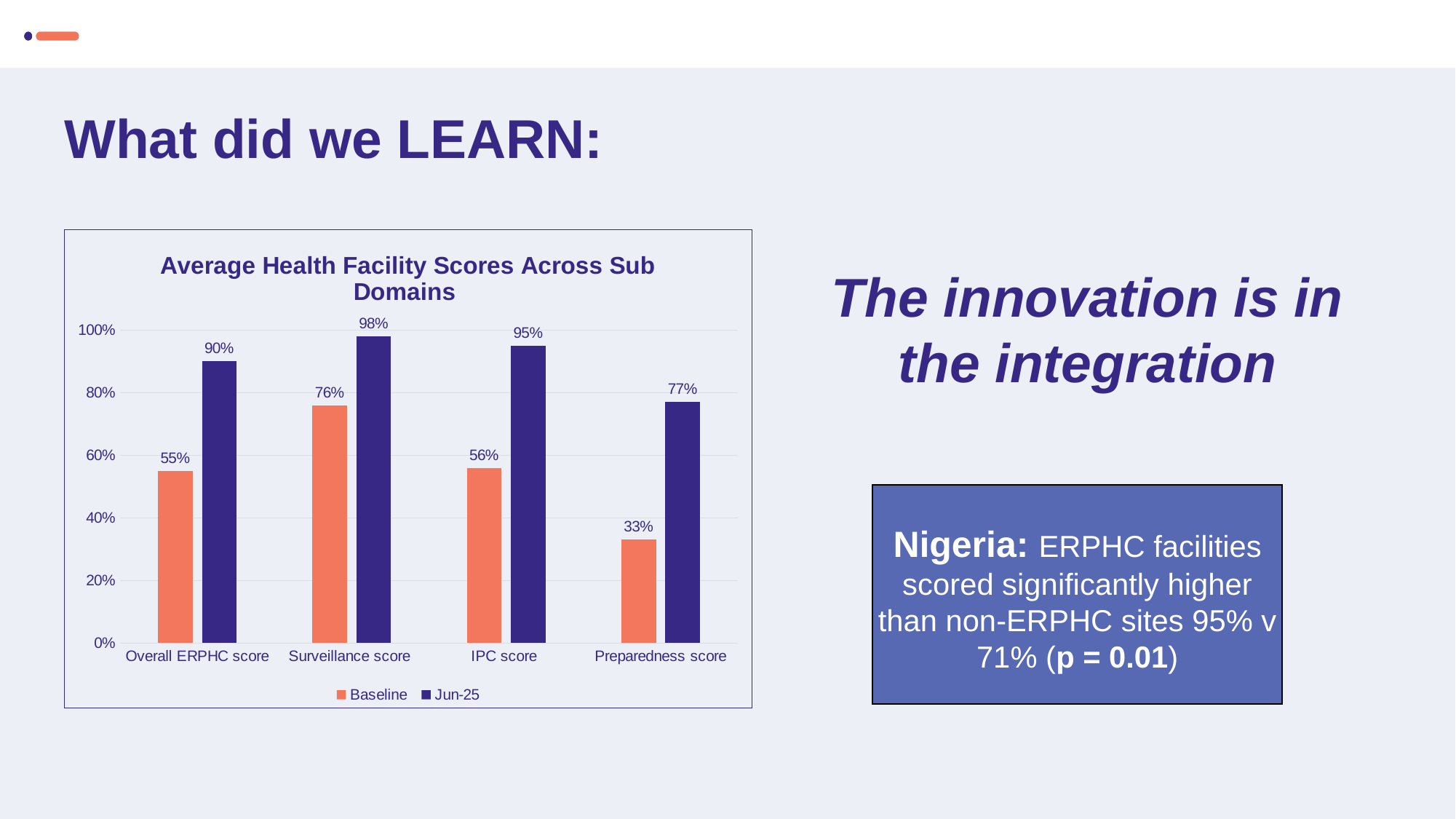
What is the Baseline value for Preparedness score? 33% What is the difference between the Jun-25 and Baseline values for Overall ERPHC score? 35% What kind of chart is shown on the slide? Bar chart Which is larger, the Baseline value for Surveillance score or the Baseline value for IPC score? Surveillance score Which category has the lowest Baseline value? Preparedness score Which category has the highest Jun-25 value? Surveillance score How many series does the legend list? 2 What is the title of the chart? Average Health Facility Scores Across Sub Domains How many categories are shown on the x axis? 4 What is the difference between the Jun-25 and Baseline values for Preparedness score? 44% What is the Jun-25 value for IPC score? 95% What is the Baseline value for Surveillance score? 76%